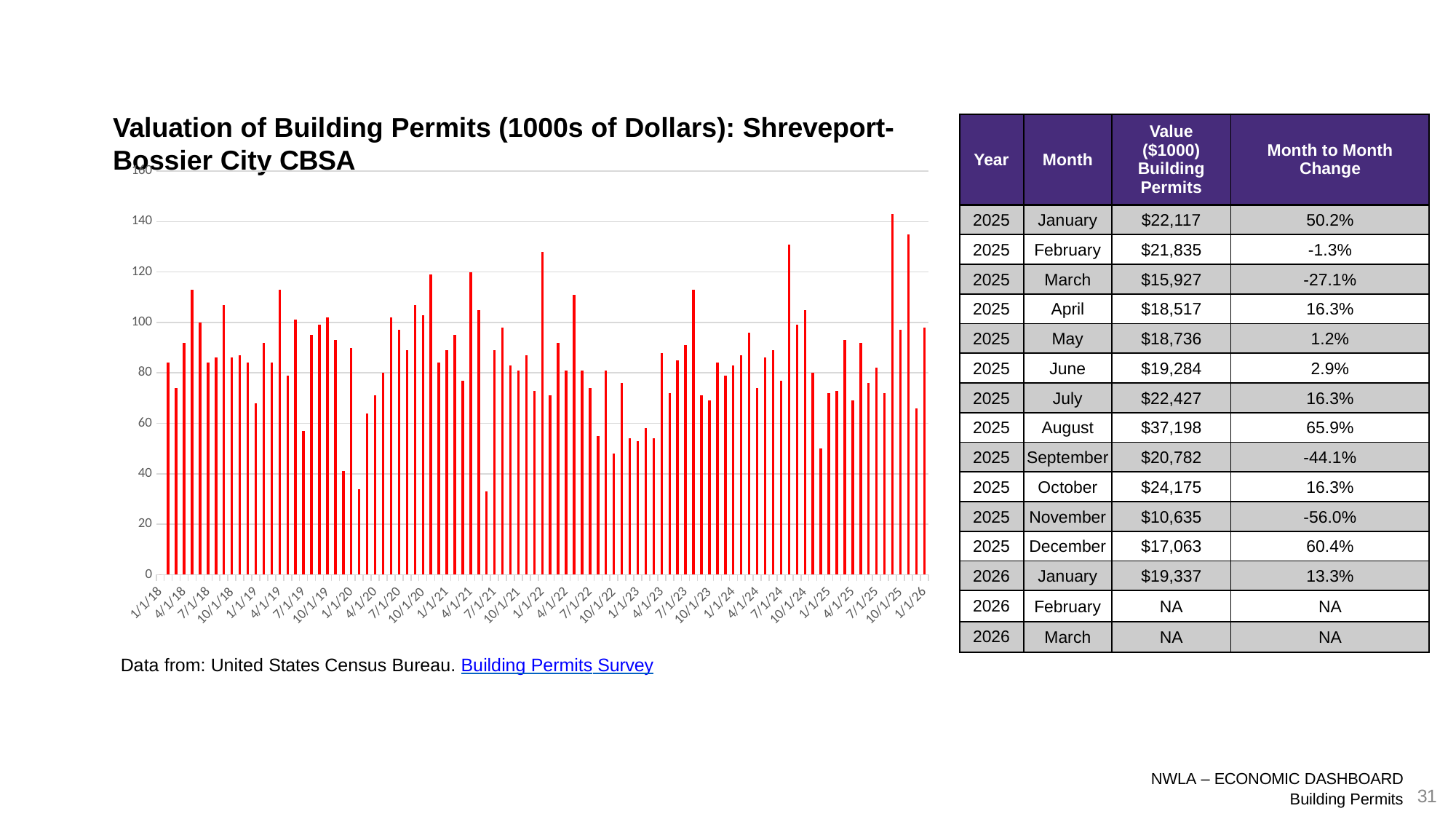
Between 1/1/20 and 7/1/20, do the bars generally rise or fall? rise Is the value for the bar at 1/1/20 greater or less than 60? greater Is the value for the bar at 10/1/25 greater or less than 120? less What colour are the bars in the chart? red Which bar is taller, the one at 10/1/25 or the one at 1/1/20? 10/1/25 What is the title of the chart? Valuation of Building Permits (1000s of Dollars): Shreveport-Bossier City CBSA What is the first date label on the x axis of the chart? 1/1/18 Is the value for the bar at 1/1/26 greater or less than 80? greater What kind of chart is shown on the slide? bar chart